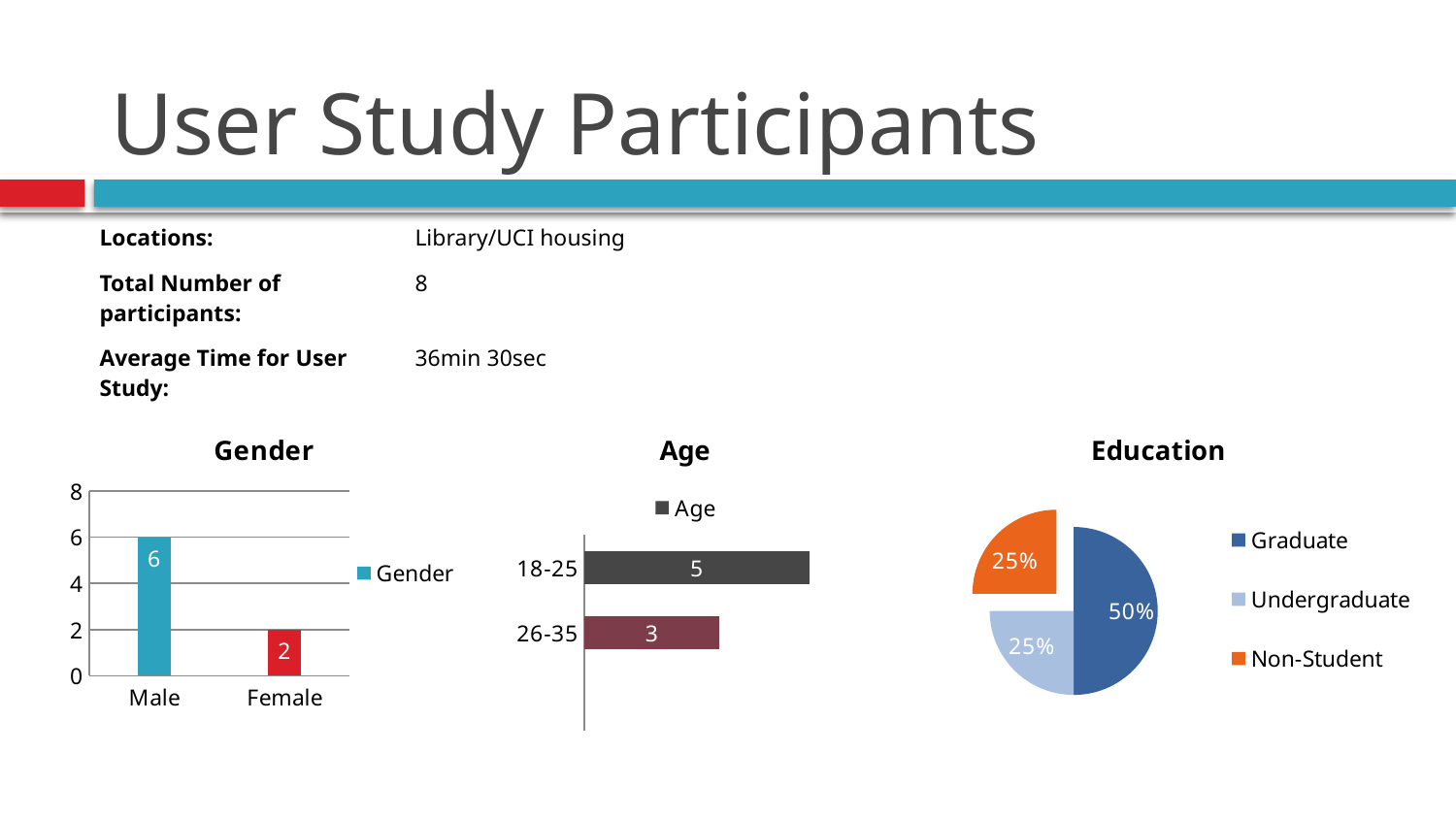
In the Education chart, what share of the pie is Graduate? 50% In the Age chart, what is the value for 26-35? 3 In the Gender chart, which category has the highest value? Male In the Age chart, which age group has the lowest value? 26-35 In the Education chart, what share of the pie is Non-Student? 25% How many entries does the legend of the Education chart list? 3 What kind of chart is the Gender chart? Bar chart In the Gender chart, what is the value for Female? 2 In the Gender chart, what is the difference between the Male and Female values? 4 In the Age chart, what is the value for 18-25? 5 How many categories does the Age chart show? 2 In the Gender chart, what is the value for Male? 6